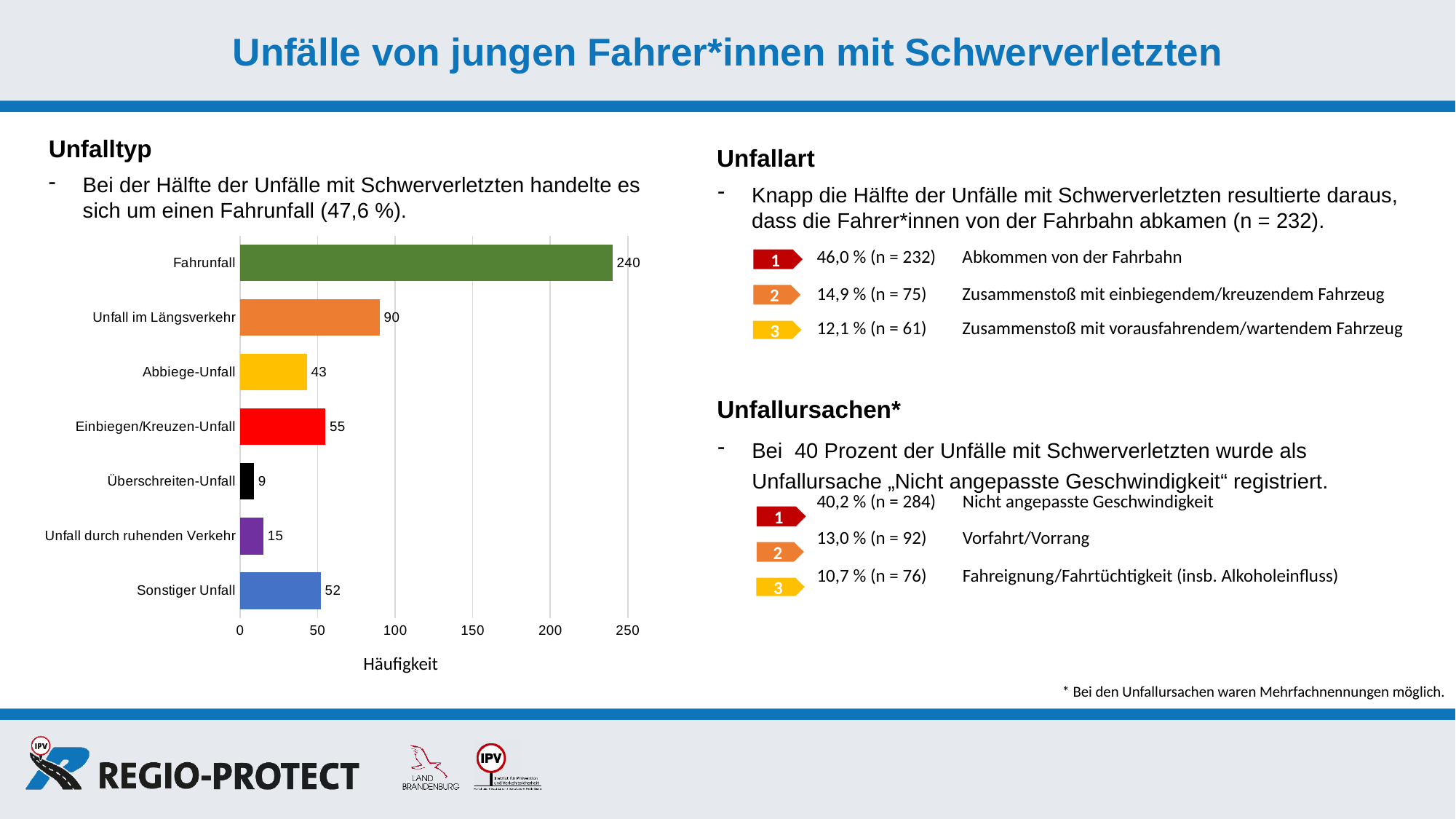
What is the label of the horizontal axis of the bar chart? Häufigkeit What is the value for Sonstiger Unfall in the bar chart? 52 What is the value for Unfall im Längsverkehr in the bar chart? 90 What is the value for Fahrunfall in the bar chart? 240 Which is larger in the bar chart: Einbiegen/Kreuzen-Unfall or Abbiege-Unfall? Einbiegen/Kreuzen-Unfall What is the difference between the values for Fahrunfall and Unfall im Längsverkehr? 150 Is the value for Unfall durch ruhenden Verkehr greater or less than 50? less What is the value for Überschreiten-Unfall in the bar chart? 9 Which category has the lowest value in the bar chart? Überschreiten-Unfall How many categories are shown in the bar chart? 7 Which category has the highest value in the bar chart? Fahrunfall What kind of chart is shown on the slide? bar chart